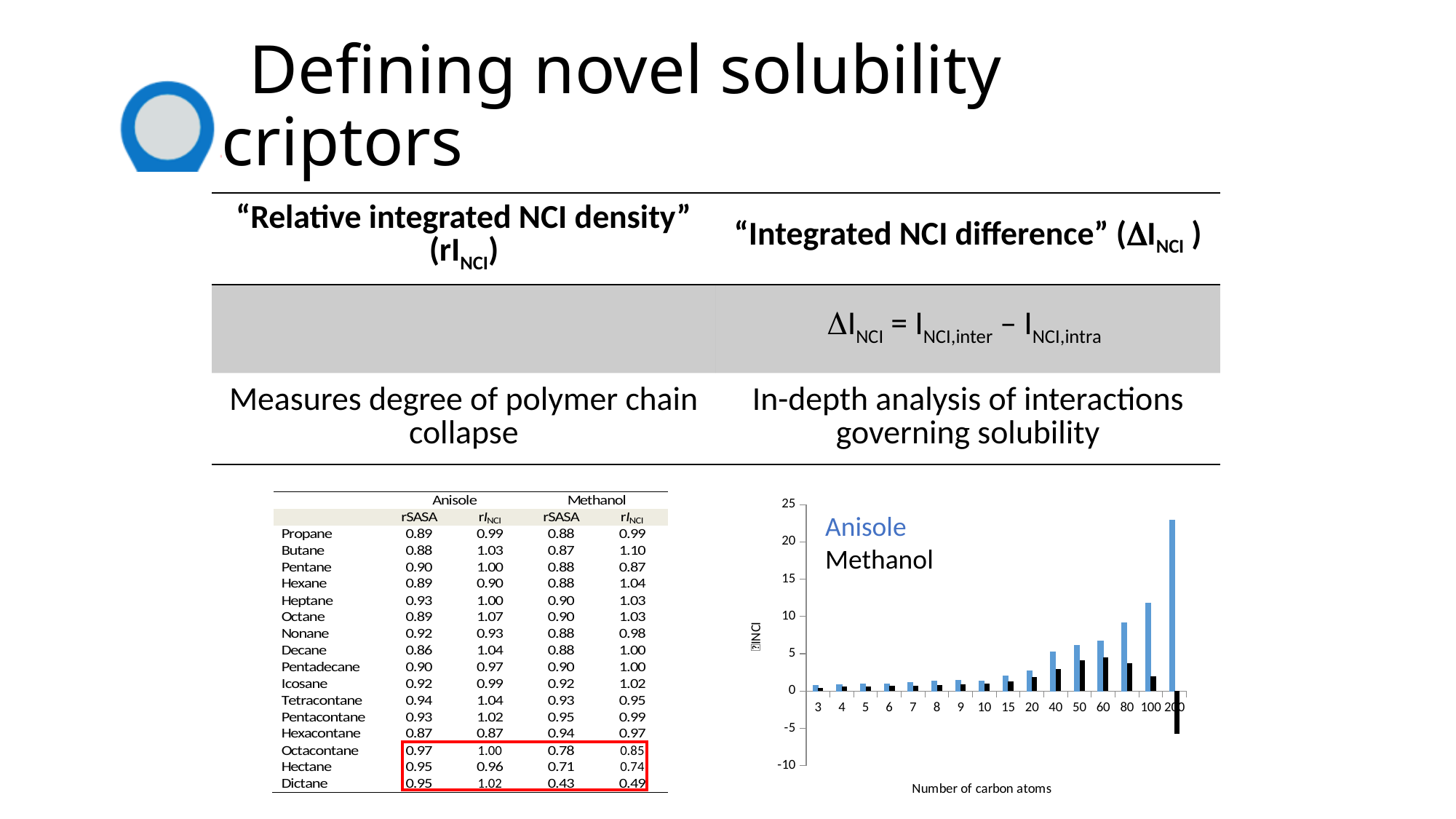
How many carbon-atom categories are plotted along the x axis of the bar chart? 16 In the bar chart, is the Methanol value at 200 carbon atoms greater or less than 0? less In the bar chart, is the Anisole value at 100 carbon atoms greater or less than 10? greater In the bar chart, is the Anisole value at 200 carbon atoms greater or less than 20? greater How many series does the bar chart on the right show? 2 In the bar chart, which series has the larger value at 100 carbon atoms, Anisole or Methanol? Anisole In the bar chart, at which number of carbon atoms is the Methanol value lowest? 200 What kind of chart is shown on the right of the slide? bar chart In the bar chart, do the Anisole values generally rise or fall as the number of carbon atoms increases? rise In the bar chart, at which number of carbon atoms is the Anisole value highest? 200 What is the x-axis title of the bar chart? Number of carbon atoms